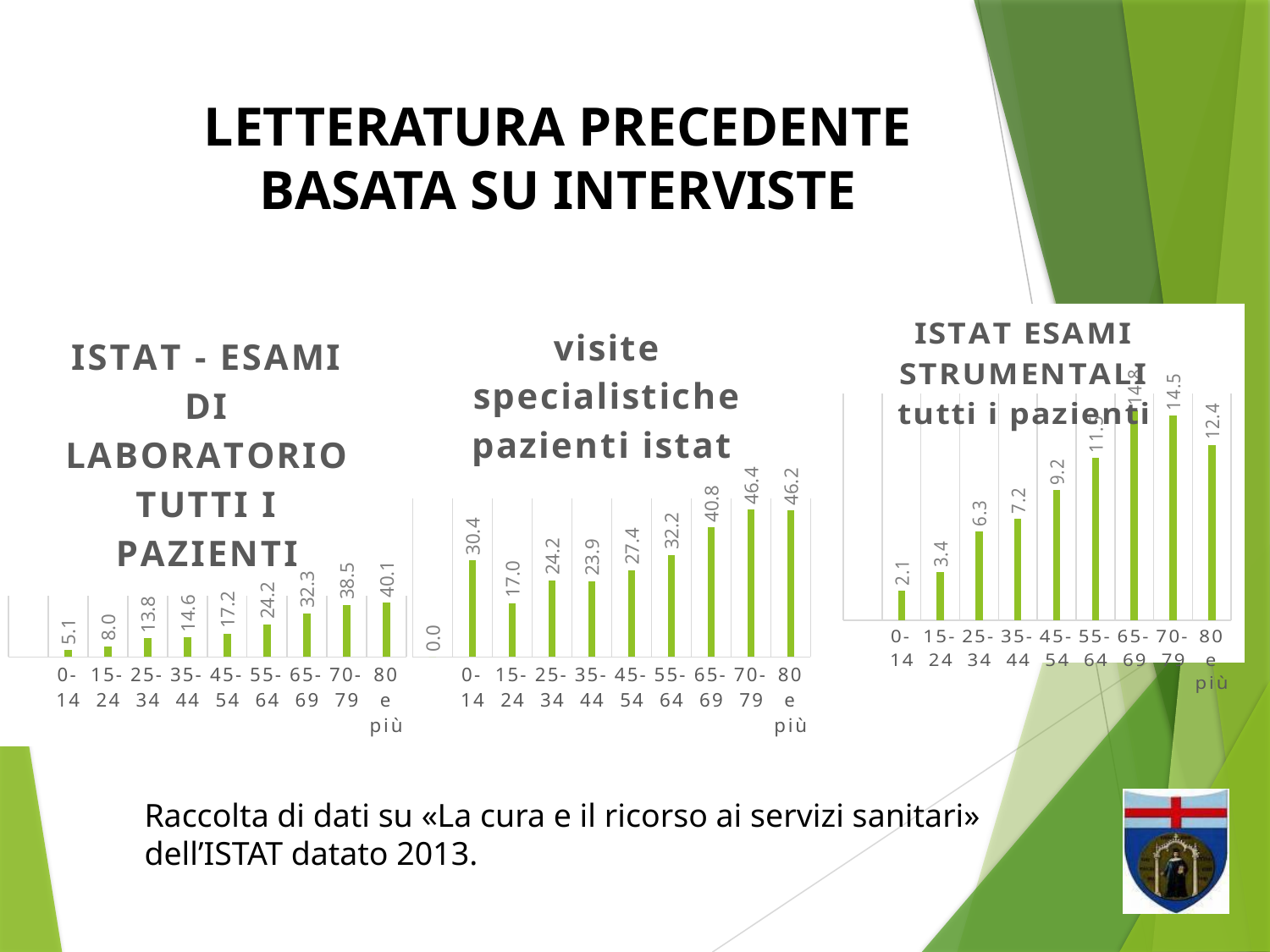
What type of chart is the chart titled 'ISTAT - ESAMI DI LABORATORIO TUTTI I PAZIENTI'? bar chart In the chart titled 'visite specialistiche pazienti istat', what is the value for the 15-24 age group? 17.0 In the chart titled 'ISTAT - ESAMI DI LABORATORIO TUTTI I PAZIENTI', do the values rise or fall as the age groups increase along the x axis? rise In the chart titled 'ISTAT - ESAMI DI LABORATORIO TUTTI I PAZIENTI', what is the value for the 0-14 age group? 5.1 In the chart titled 'visite specialistiche pazienti istat', which age group has the lowest value? 15-24 How many age groups are shown on the x axis of the chart titled 'ISTAT ESAMI STRUMENTALI tutti i pazienti'? 9 In the chart titled 'ISTAT - ESAMI DI LABORATORIO TUTTI I PAZIENTI', what is the difference between the values for 70-79 and 65-69? 6.2 In the chart titled 'ISTAT ESAMI STRUMENTALI tutti i pazienti', what is the value for the 45-54 age group? 9.2 In the chart titled 'visite specialistiche pazienti istat', which is larger: the value for 0-14 or the value for 45-54? 0-14 In the chart titled 'ISTAT - ESAMI DI LABORATORIO TUTTI I PAZIENTI', which age group has the highest value? 80 e più In the chart titled 'ISTAT ESAMI STRUMENTALI tutti i pazienti', which age group has the lowest value? 0-14 In the chart titled 'visite specialistiche pazienti istat', what is the difference between the values for 65-69 and 55-64? 8.6